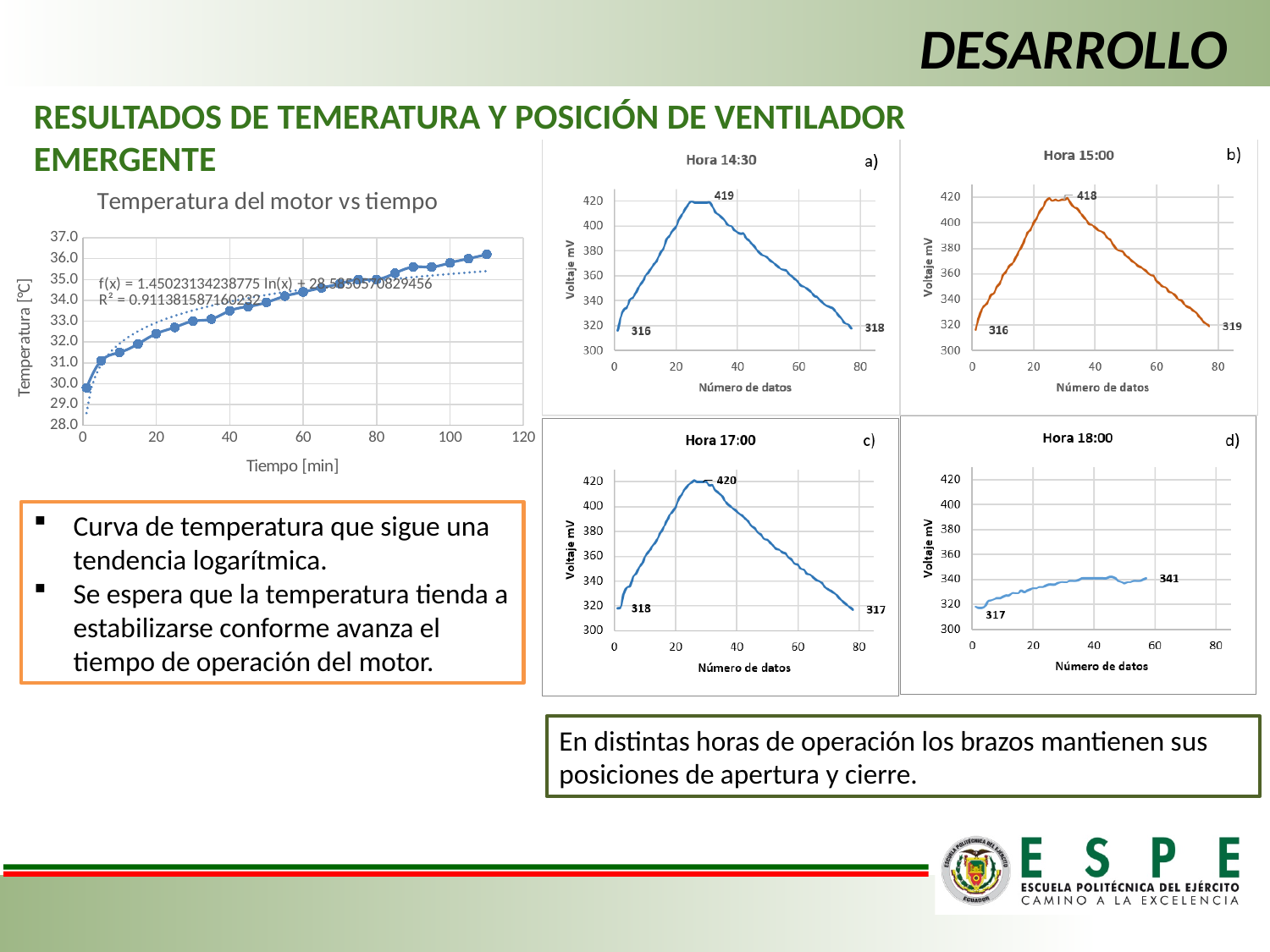
In the chart titled 'Hora 14:30', what is the difference between the labelled peak value and the labelled starting value? 103 What is the y-axis label of the chart titled 'Hora 14:30'? Voltaje mV What is the x-axis label of the chart titled 'Temperatura del motor vs tiempo'? Tiempo [min] In the chart titled 'Hora 17:00', what is the peak voltage value labelled on the curve? 420 Which is larger: the labelled peak in the 'Hora 17:00' chart or the labelled peak in the 'Hora 15:00' chart? Hora 17:00 In the chart titled 'Temperatura del motor vs tiempo', is the temperature at 100 minutes greater or less than 35.0? greater In the chart titled 'Hora 15:00', what is the peak voltage value labelled on the curve? 418 In the chart titled 'Hora 18:00', what is the final labelled voltage value at the end of the curve? 341 In the chart titled 'Hora 15:00', what is the labelled voltage value at the end of the curve? 319 In the chart titled 'Hora 14:30', what is the peak voltage value labelled on the curve? 419 In the chart titled 'Temperatura del motor vs tiempo', do the temperature values rise or fall as time increases? rise In the chart titled 'Hora 18:00', what is the labelled starting voltage value? 317